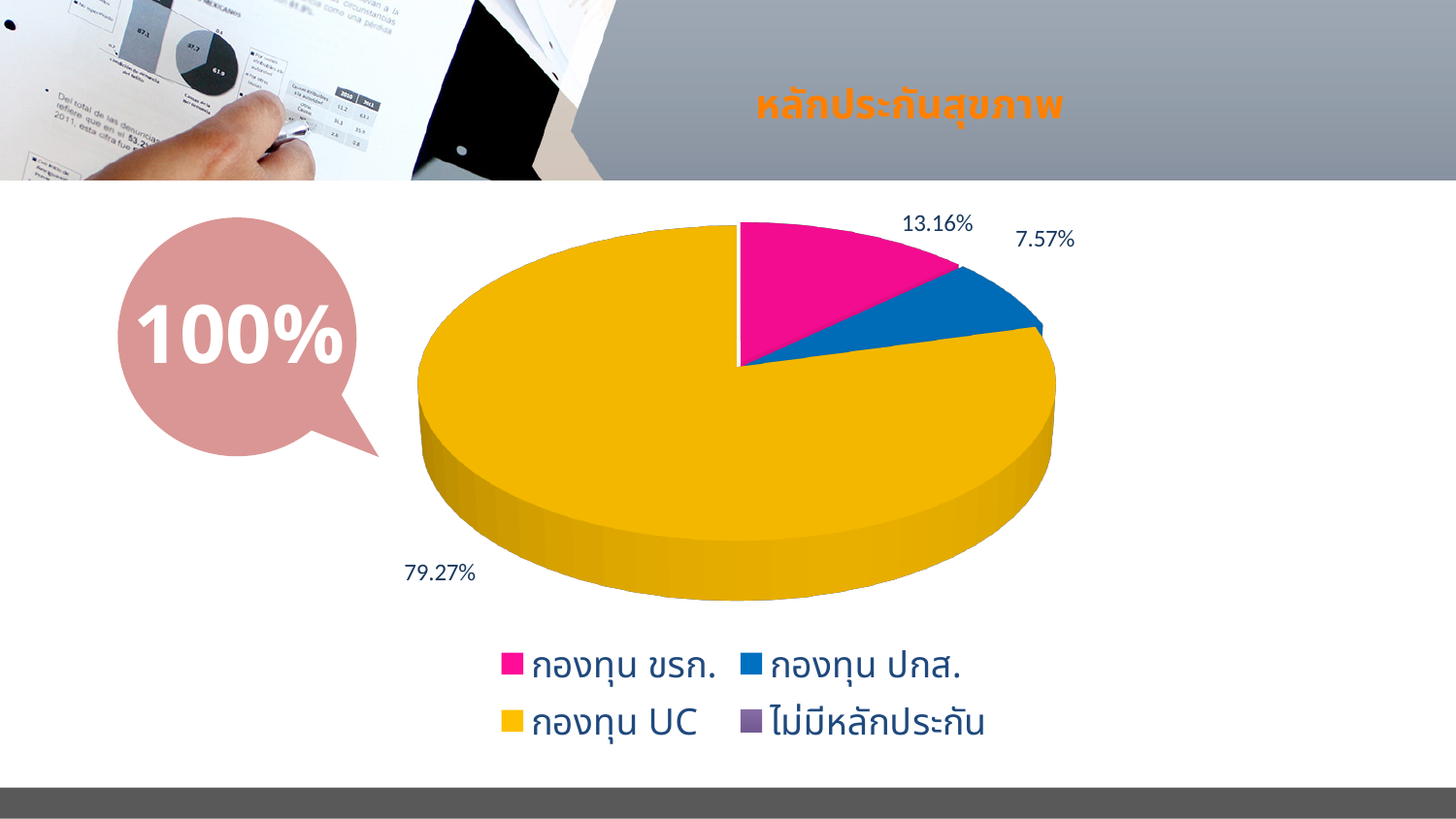
What is the value for กองทุน UC? 79.27% Which category has the largest slice of the pie? กองทุน UC What is the difference between the values for กองทุน UC and กองทุน ขรก.? 66.11% What is the difference between the values for กองทุน ขรก. and กองทุน ปกส.? 5.59% What is the value for กองทุน ปกส.? 7.57% What is the value for กองทุน ขรก.? 13.16% What kind of chart is shown on the slide? Pie chart Which is larger, the slice for กองทุน ขรก. or the slice for กองทุน ปกส.? กองทุน ขรก. Which of the labelled slices is the smallest? กองทุน ปกส. What colour is the slice for กองทุน UC? Yellow How many entries does the legend list? 4 What is the title of the chart? หลักประกันสุขภาพ